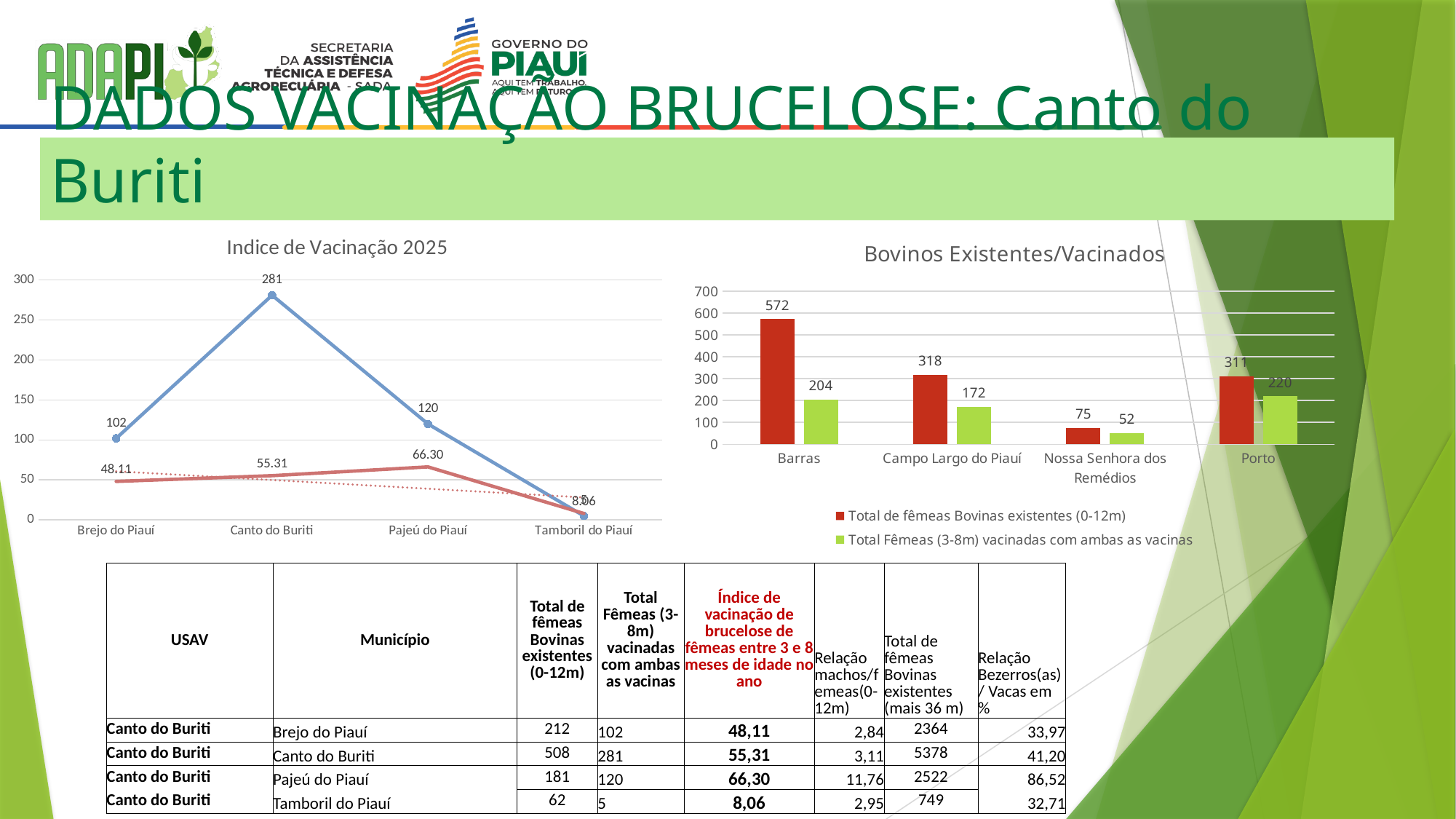
In the 'Bovinos Existentes/Vacinados' chart, what is the value of 'Total Fêmeas (3-8m) vacinadas com ambas as vacinas' for Porto? 220 How many categories are shown on the x axis of the 'Indice de Vacinação 2025' chart? 4 In the 'Indice de Vacinação 2025' chart, what is the value of the red line for Pajeú do Piauí? 66.30 In the 'Bovinos Existentes/Vacinados' chart, how many series does the legend list? 2 In the 'Bovinos Existentes/Vacinados' chart, which category has the lowest value for 'Total de fêmeas Bovinas existentes (0-12m)'? Nossa Senhora dos Remédios In the 'Bovinos Existentes/Vacinados' chart, is the value for 'Total de fêmeas Bovinas existentes (0-12m)' for Porto greater or less than 300? greater In the 'Indice de Vacinação 2025' chart, which category has the highest value on the blue line? Canto do Buriti In the 'Bovinos Existentes/Vacinados' chart, what is the value of 'Total de fêmeas Bovinas existentes (0-12m)' for Barras? 572 In the 'Indice de Vacinação 2025' chart, is the blue line value for Brejo do Piauí larger or smaller than the blue line value for Pajeú do Piauí? smaller In the 'Bovinos Existentes/Vacinados' chart, what is the difference between the two series for Campo Largo do Piauí? 146 In the 'Indice de Vacinação 2025' chart, what is the value of the blue line for Canto do Buriti? 281 What kind of chart is 'Bovinos Existentes/Vacinados'? bar chart